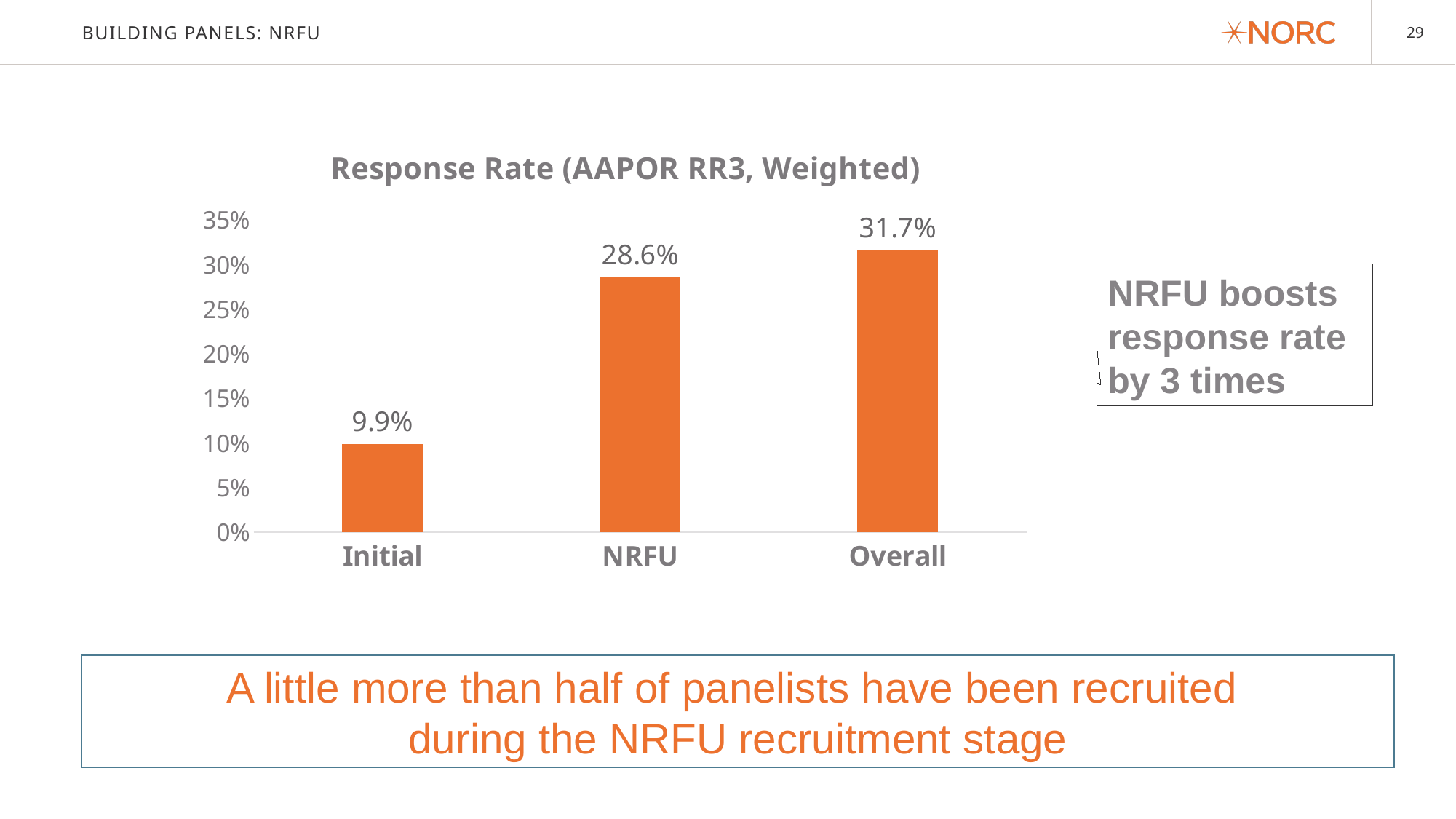
Is the value for NRFU greater or less than 25%? greater What is the difference between the NRFU and Initial response rates? 18.7% What kind of chart is shown on the slide? Bar chart Which category has the highest response rate? Overall Which category has the lowest response rate? Initial Which is larger, the response rate for NRFU or for Initial? NRFU What is the difference between the Overall and Initial response rates? 21.8% What is the response rate for Overall? 31.7% How many categories are shown on the x axis? 3 What is the response rate for Initial? 9.9% What is the title of the chart? Response Rate (AAPOR RR3, Weighted) What is the response rate for NRFU? 28.6%